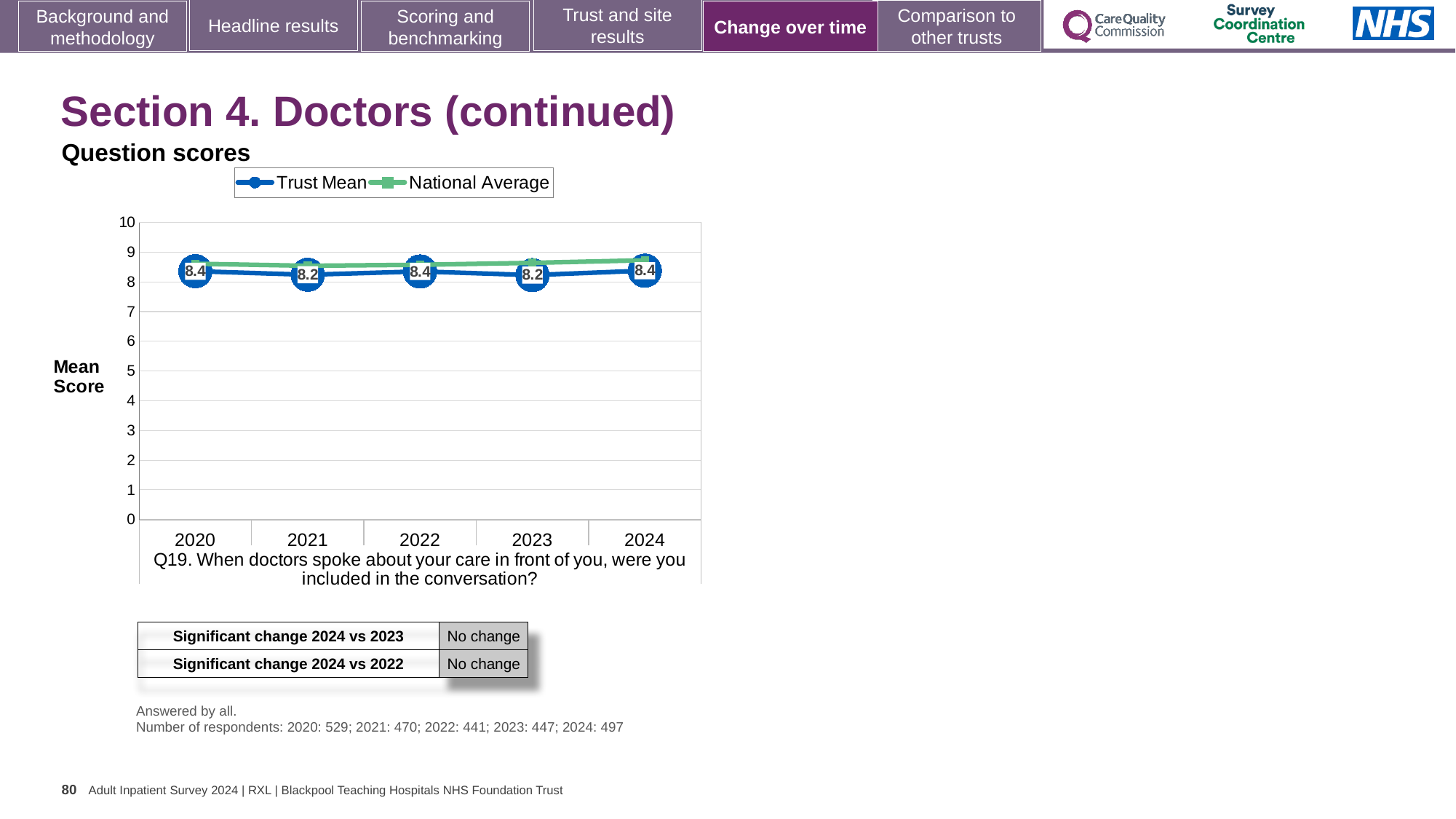
What is the difference between the Trust Mean in 2024 and in 2023? 0.2 How many years are plotted on the x axis? 5 What is the Trust Mean for 2021? 8.2 What is the Trust Mean for 2024? 8.4 How many series does the legend list? 2 Which year has the larger Trust Mean, 2022 or 2023? 2022 Is the National Average for 2024 greater or less than 8? greater What kind of chart is shown? line chart Is the Trust Mean for 2023 greater or less than 9? less In 2024, which is higher, the Trust Mean or the National Average? National Average What are the two series named in the legend? Trust Mean and National Average What is the Trust Mean for 2020? 8.4